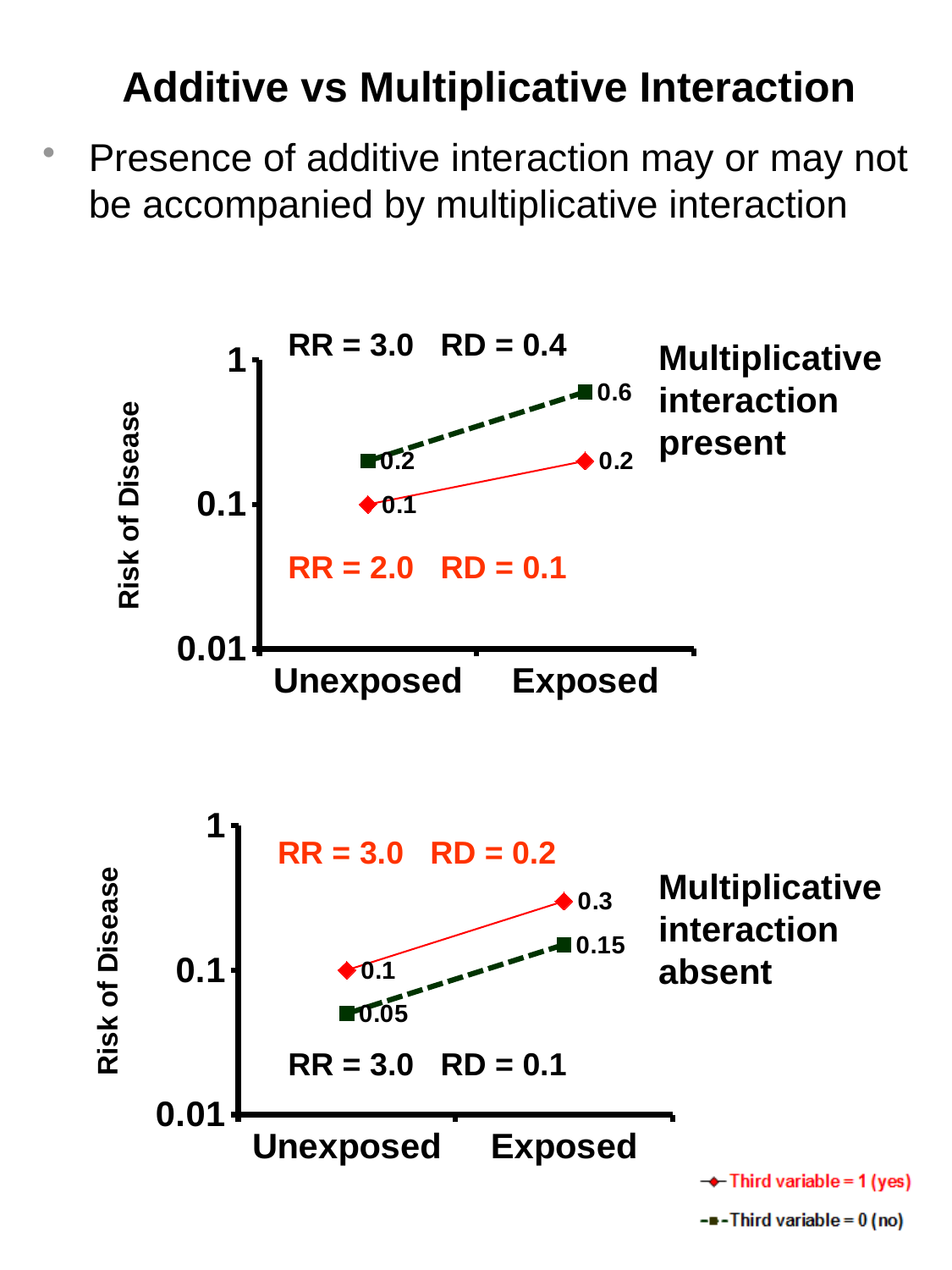
In the top chart (multiplicative interaction present), which series has the higher risk for the Exposed group? Third variable = 0 (no) What kind of chart is the top chart? line chart In the top chart (multiplicative interaction present), what is the difference in risk between Exposed and Unexposed for the Third variable = 0 (no) series? 0.4 In the bottom chart (multiplicative interaction absent), what is the difference in risk between Exposed and Unexposed for the Third variable = 1 (yes) series? 0.2 How many categories are shown on the x axis of the top chart? 2 In the bottom chart (multiplicative interaction absent), does the risk of disease rise or fall from Unexposed to Exposed for the Third variable = 0 (no) series? rise In the top chart (multiplicative interaction present), what is the risk of disease for the Unexposed group in the Third variable = 1 (yes) series? 0.1 How many series does the legend list? 2 In the bottom chart (multiplicative interaction absent), what is the risk of disease for the Unexposed group in the Third variable = 0 (no) series? 0.05 In the top chart (multiplicative interaction present), what is the risk of disease for the Exposed group in the Third variable = 0 (no) series? 0.6 In the bottom chart (multiplicative interaction absent), what is the risk of disease for the Exposed group in the Third variable = 1 (yes) series? 0.3 In the bottom chart (multiplicative interaction absent), which series has the higher risk for the Exposed group? Third variable = 1 (yes)